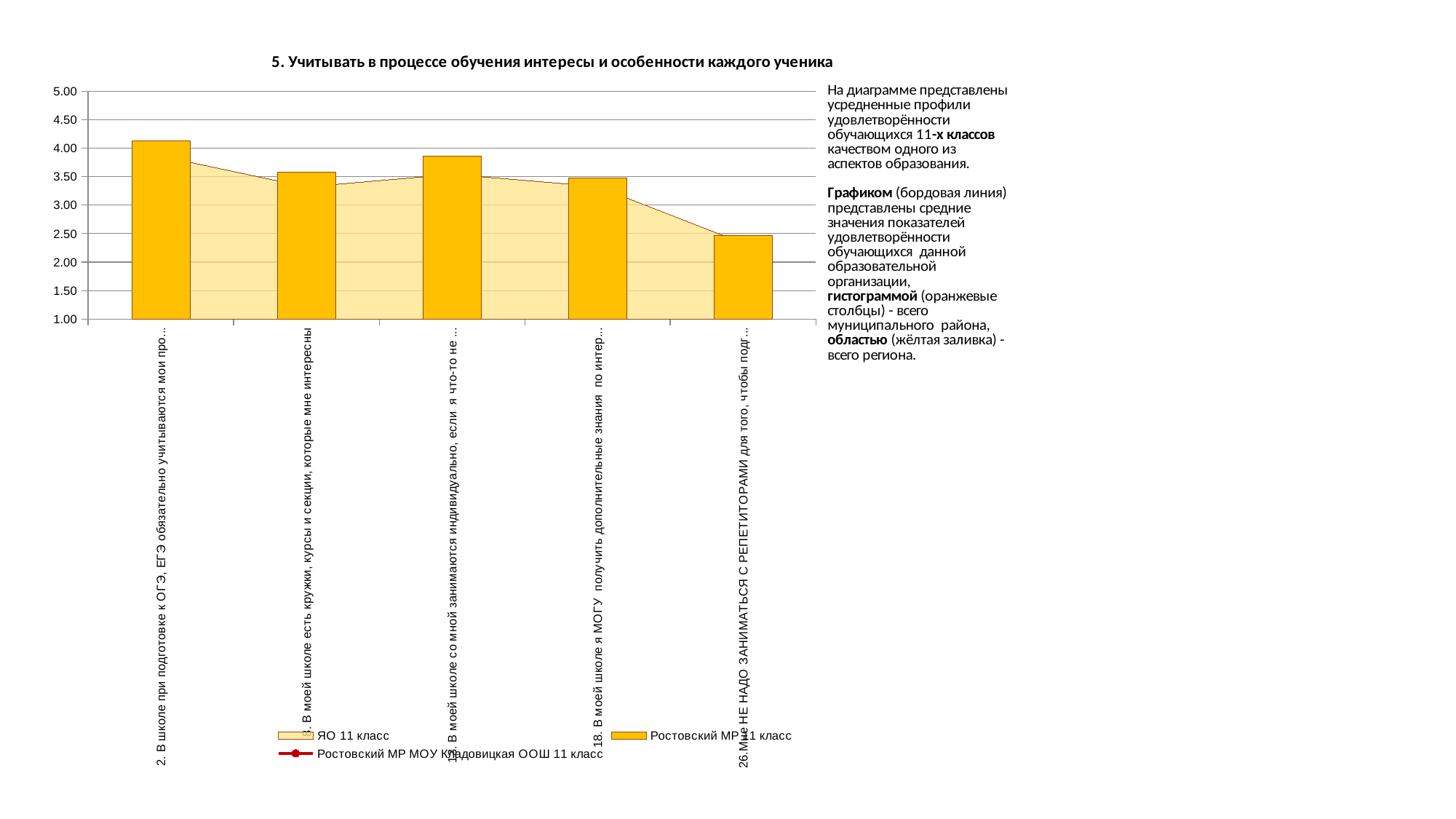
How many categories (bars) are plotted on the chart? 5 Which has the larger Ростовский МР 11 класс value: category 2 (подготовка к ОГЭ, ЕГЭ) or category 26 (НЕ НАДО ЗАНИМАТЬСЯ С РЕПЕТИТОРАМИ)? 2. В школе при подготовке к ОГЭ, ЕГЭ обязательно учитываются мои про... Is the Ростовский МР 11 класс value for category 26 (Мне НЕ НАДО ЗАНИМАТЬСЯ С РЕПЕТИТОРАМИ...) greater or less than 3.00? less Is the Ростовский МР 11 класс value for category 13 (В моей школе со мной занимаются индивидуально...) greater or less than 3.50? greater Which category has the highest orange bar (Ростовский МР 11 класс)? 2. В школе при подготовке к ОГЭ, ЕГЭ обязательно учитываются мои про... Which category has the lowest orange bar (Ростовский МР 11 класс)? 26. Мне НЕ НАДО ЗАНИМАТЬСЯ С РЕПЕТИТОРАМИ для того, чтобы подг... Is the Ростовский МР 11 класс value for category 18 (В моей школе я МОГУ получить дополнительные знания...) greater or less than 3.00? greater What colour are the bars for the series Ростовский МР 11 класс? Orange How many series does the chart legend list? 3 What is the title of the chart? 5. Учитывать в процессе обучения интересы и особенности каждого ученика